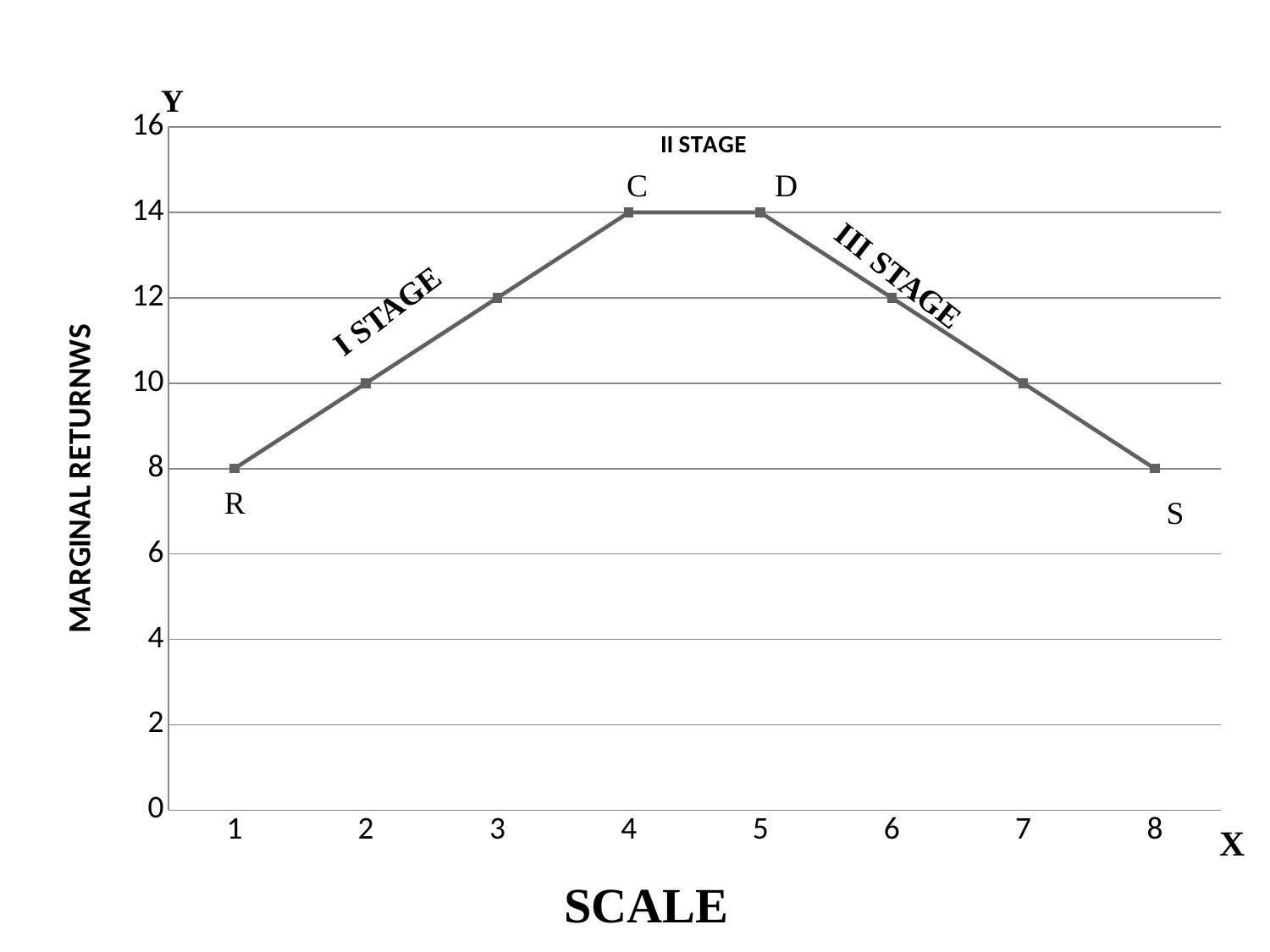
What kind of chart is shown on the slide? line chart How many data points are plotted on the line? 8 What is the lowest marginal returns value plotted on the chart? 8 What is the marginal returns value at scale 1? 8 Does the line rise or fall between scale 5 and scale 8? fall At which scale values does the line reach its highest marginal returns? 4 and 5 What is the marginal returns value at scale 4? 14 What is the marginal returns value at scale 7? 10 What is the difference between the marginal returns at scale 4 and at scale 2? 4 What is the label of the x axis? SCALE Is the marginal returns value at scale 2 greater or less than 12? less Which has a higher marginal returns value, scale 3 or scale 6? They are equal (12)